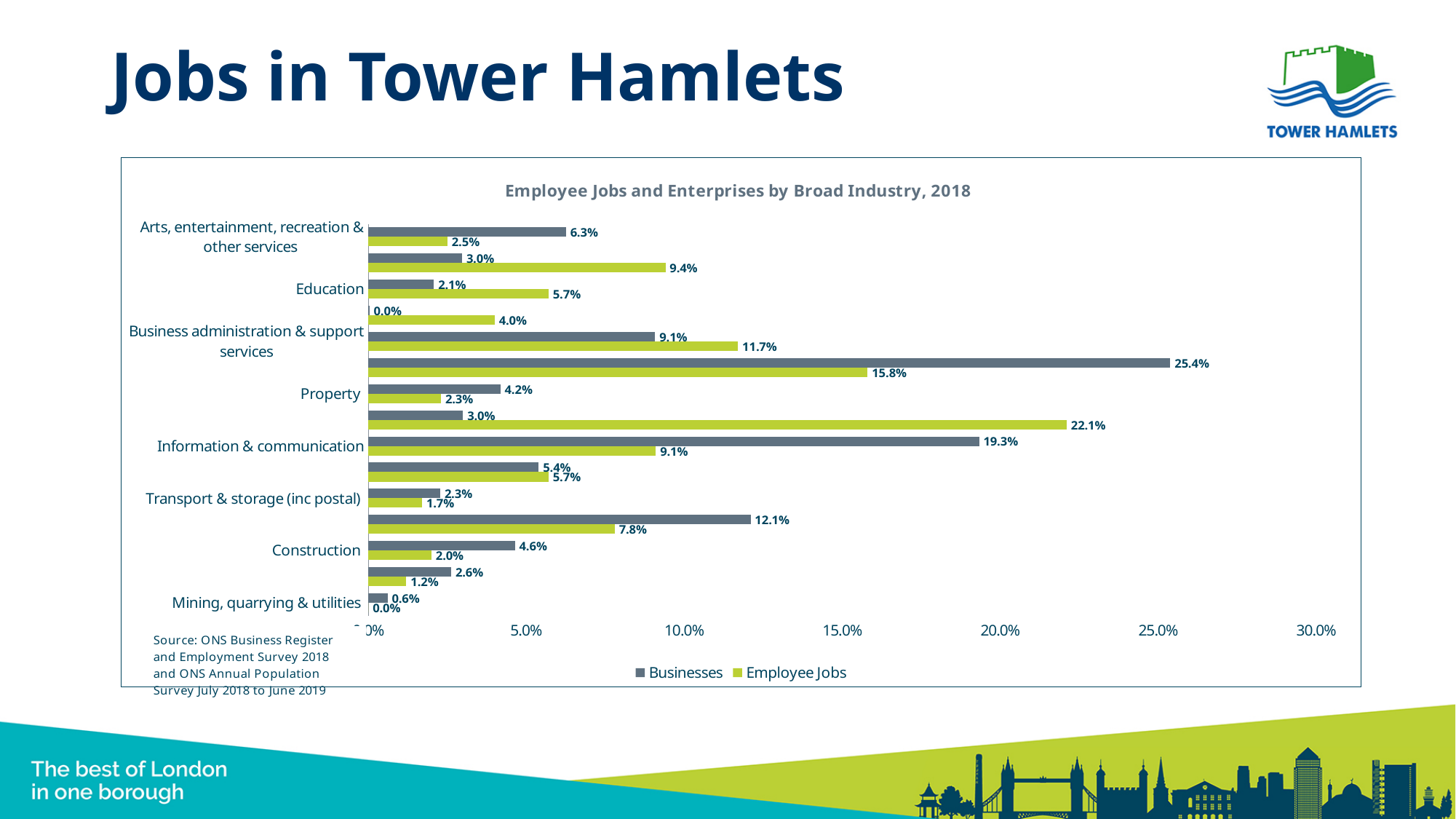
What is the Employee Jobs value for Mining, quarrying & utilities? 0.0% How many series does the legend list? 2 What is the Employee Jobs value for Education? 5.7% What is the Employee Jobs value for Business administration & support services? 11.7% What is the title of the chart? Employee Jobs and Enterprises by Broad Industry, 2018 What kind of chart is shown on the slide? Bar chart What is the difference between the Employee Jobs and Businesses values for Education? 3.6% What is the Businesses value for Information & communication? 19.3% What is the Businesses value for Arts, entertainment, recreation & other services? 6.3% What is the difference between the Businesses and Employee Jobs values for Information & communication? 10.2% Which has a higher Businesses value: Property or Transport & storage (inc postal)? Property Which is larger for Construction: the Businesses value or the Employee Jobs value? Businesses